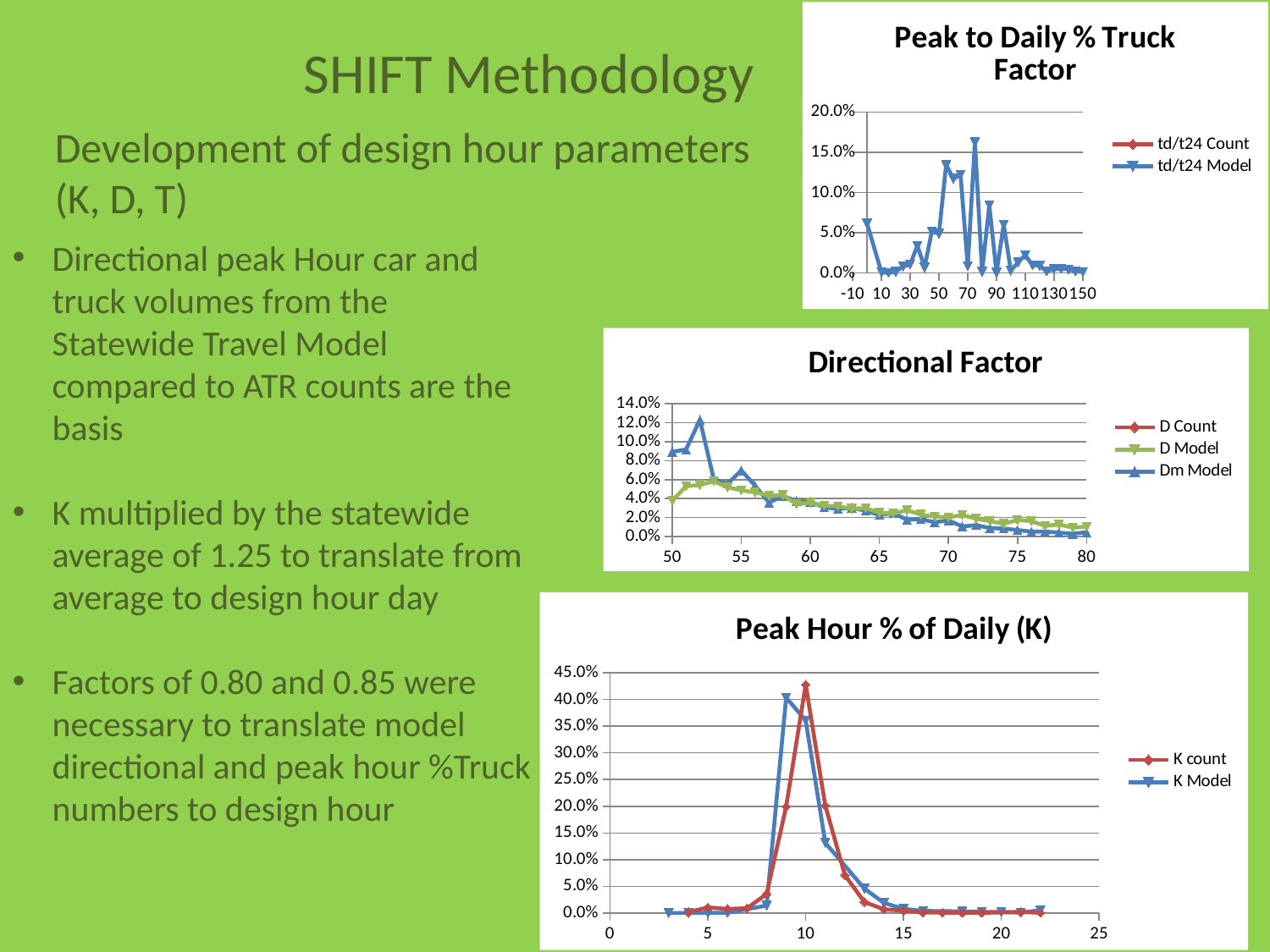
What are the legend entries of the "Peak Hour % of Daily (K)" chart? K count, K Model In the "Peak Hour % of Daily (K)" chart, at x = 9, which series has the higher value, K count or K Model? K Model How many series does the legend of the "Peak to Daily % Truck Factor" chart list? 2 What kind of chart is the "Peak Hour % of Daily (K)" chart? line chart In the "Peak Hour % of Daily (K)" chart, is the highest value of the K count series greater or less than 40.0%? greater How many series does the legend of the "Directional Factor" chart list? 3 How many charts are shown on the slide? 3 In the "Directional Factor" chart, is the D Model value at x = 50 greater or less than 6.0%? less In the "Peak Hour % of Daily (K)" chart, at x = 10, which series has the higher value, K count or K Model? K count In the "Peak to Daily % Truck Factor" chart, is the highest td/t24 Model value greater or less than 15.0%? greater In the "Directional Factor" chart, do the Dm Model values generally rise or fall from x = 55 to x = 80? fall